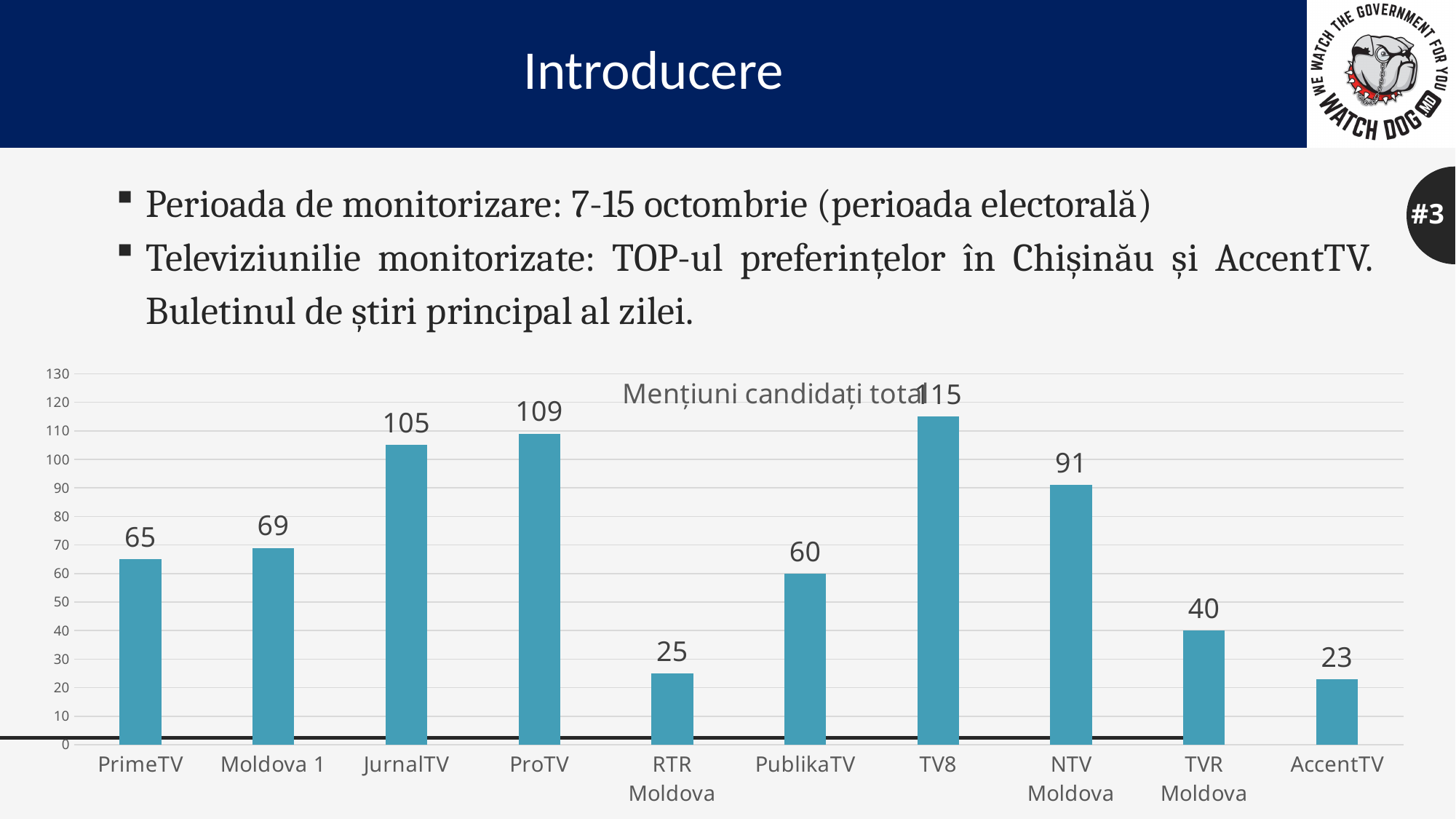
What is the value for RTR Moldova? 25 Which channel has the lowest value? AccentTV How many channels are shown on the x axis? 10 What is the difference between the values for ProTV and PrimeTV? 44 What is the value for JurnalTV? 105 What kind of chart is shown on the slide? bar chart What is the value for NTV Moldova? 91 What is the difference between the values for TV8 and AccentTV? 92 What is the title of the chart? Mențiuni candidați total Which channel has the highest value? TV8 Which is larger, the value for Moldova 1 or the value for PublikaTV? Moldova 1 Is the value for TVR Moldova greater or less than 50? less